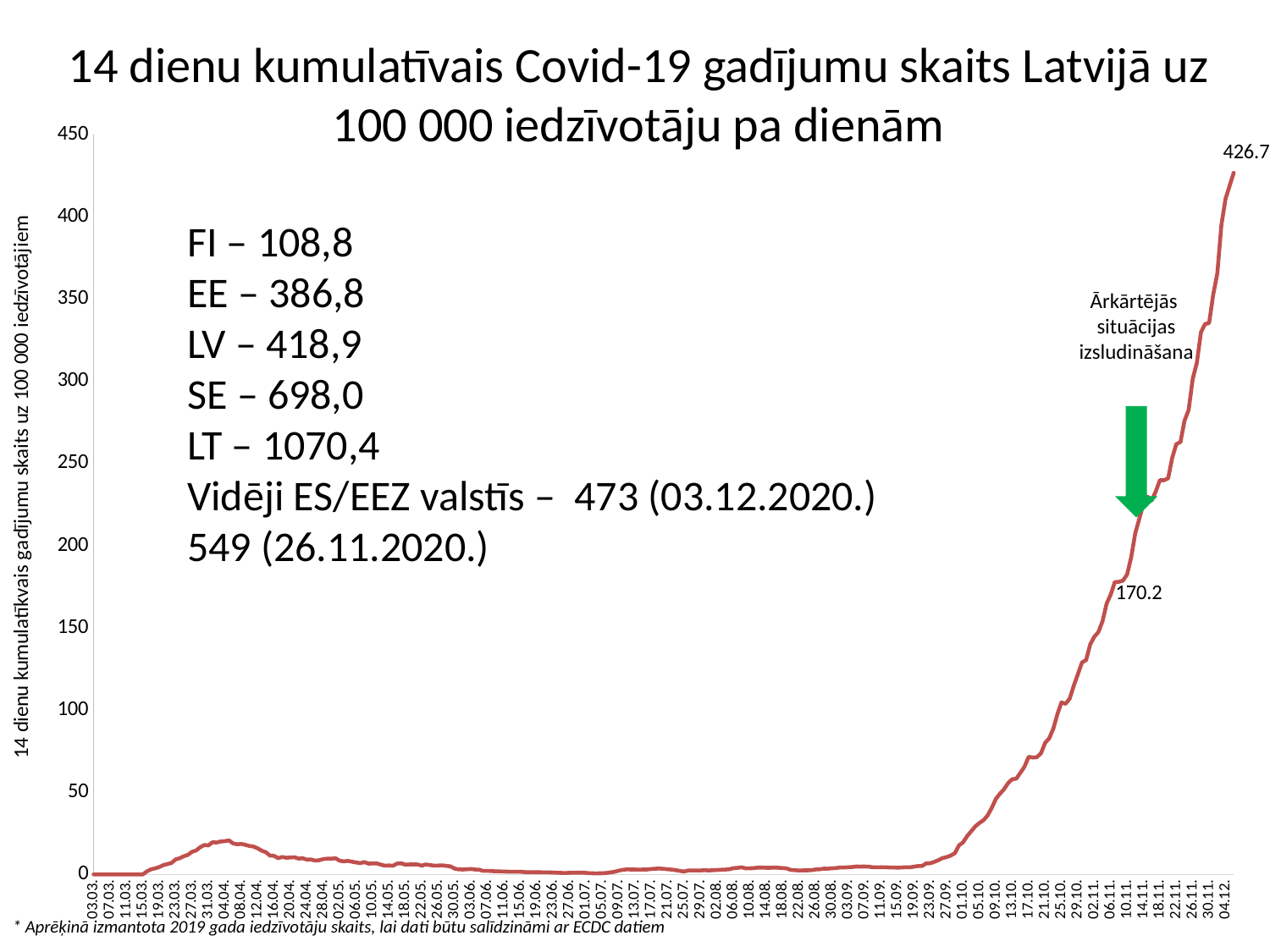
What is the value of the last data label on the line, at 04.12.? 426.7 Does the line generally rise or fall from October to December? rise Is the value at 01.10. greater or less than 50? less What is the difference between the two labelled values on the line, 426.7 and 170.2? 256.5 What kind of chart is shown on the slide? line chart Is the value at 01.07. greater or less than 50? less What value is labelled on the line near the green arrow marking the emergency situation declaration? 170.2 What does the annotation next to the green arrow say? Ārkārtējās situācijas izsludināšana Is the value at 04.12. greater or less than 400? greater What is the highest tick value shown on the y axis? 450 Which of the two labelled values on the line is larger, the one at the end of the line or the one near the green arrow? the one at the end of the line (426.7)